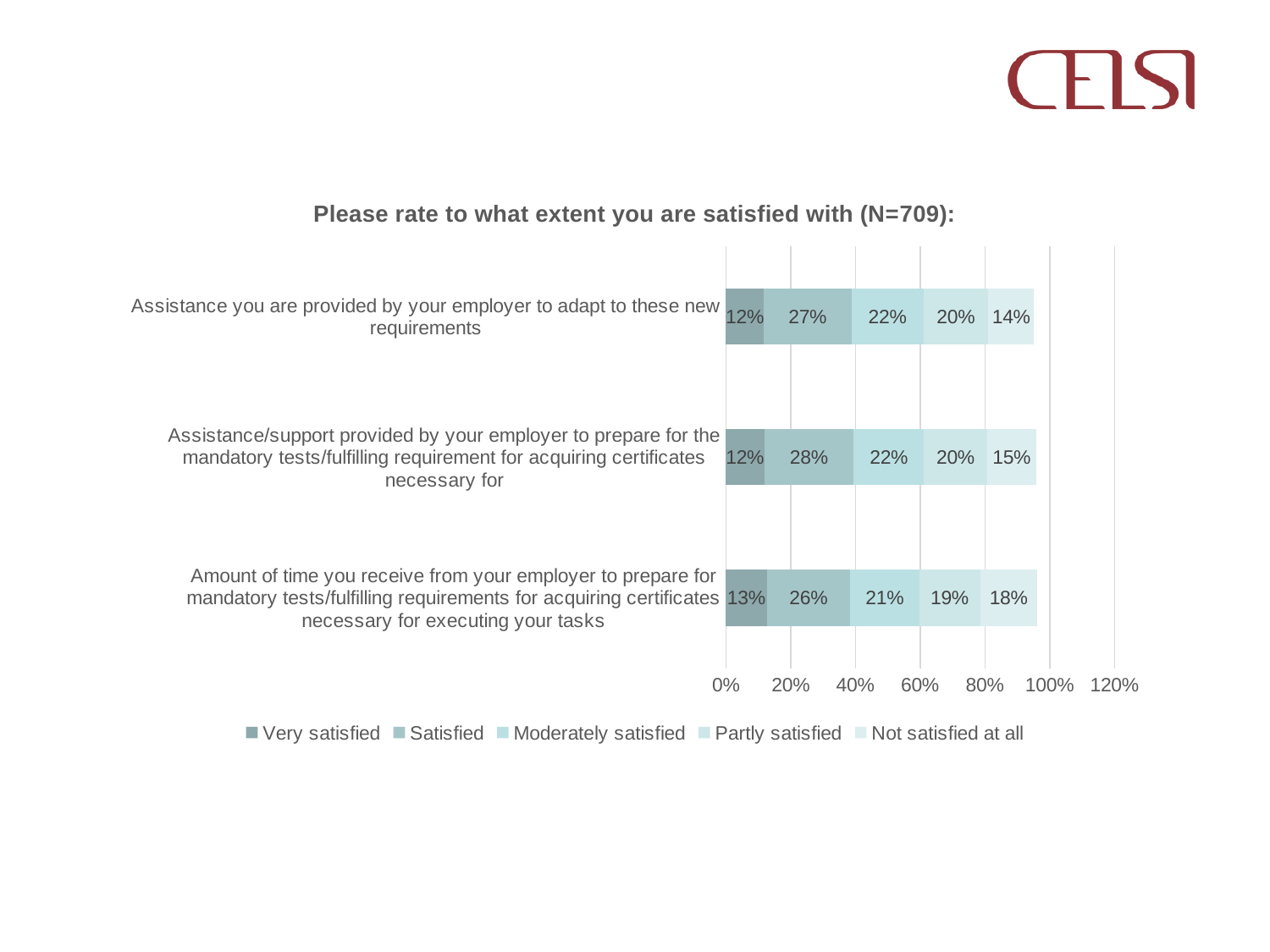
Which is larger: the 'Satisfied' share for the assistance to adapt to new requirements item or for the amount of time item? Assistance you are provided by your employer to adapt to these new requirements Which survey item has the lowest 'Satisfied' share? Amount of time you receive from your employer to prepare for mandatory tests/fulfilling requirements for acquiring certificates necessary for executing your tasks What percentage of respondents were 'Very satisfied' with the amount of time received from their employer to prepare for mandatory tests? 13% What is the difference between the 'Not satisfied at all' share for the amount of time item (18%) and for the assistance to adapt to new requirements item (14%)? 4% Which survey item has the highest 'Not satisfied at all' share? Amount of time you receive from your employer to prepare for mandatory tests/fulfilling requirements for acquiring certificates necessary for executing your tasks How many series does the legend list? 5 What is the title of the chart? Please rate to what extent you are satisfied with (N=709): What percentage were 'Partly satisfied' with the amount of time received from their employer to prepare for mandatory tests? 19% What kind of chart is shown on the slide? Stacked bar chart What percentage were 'Not satisfied at all' with the assistance provided by their employer to adapt to these new requirements? 14% What percentage were 'Satisfied' with the assistance/support provided by their employer to prepare for the mandatory tests? 28% How many categories (survey items) are plotted in the chart? 3